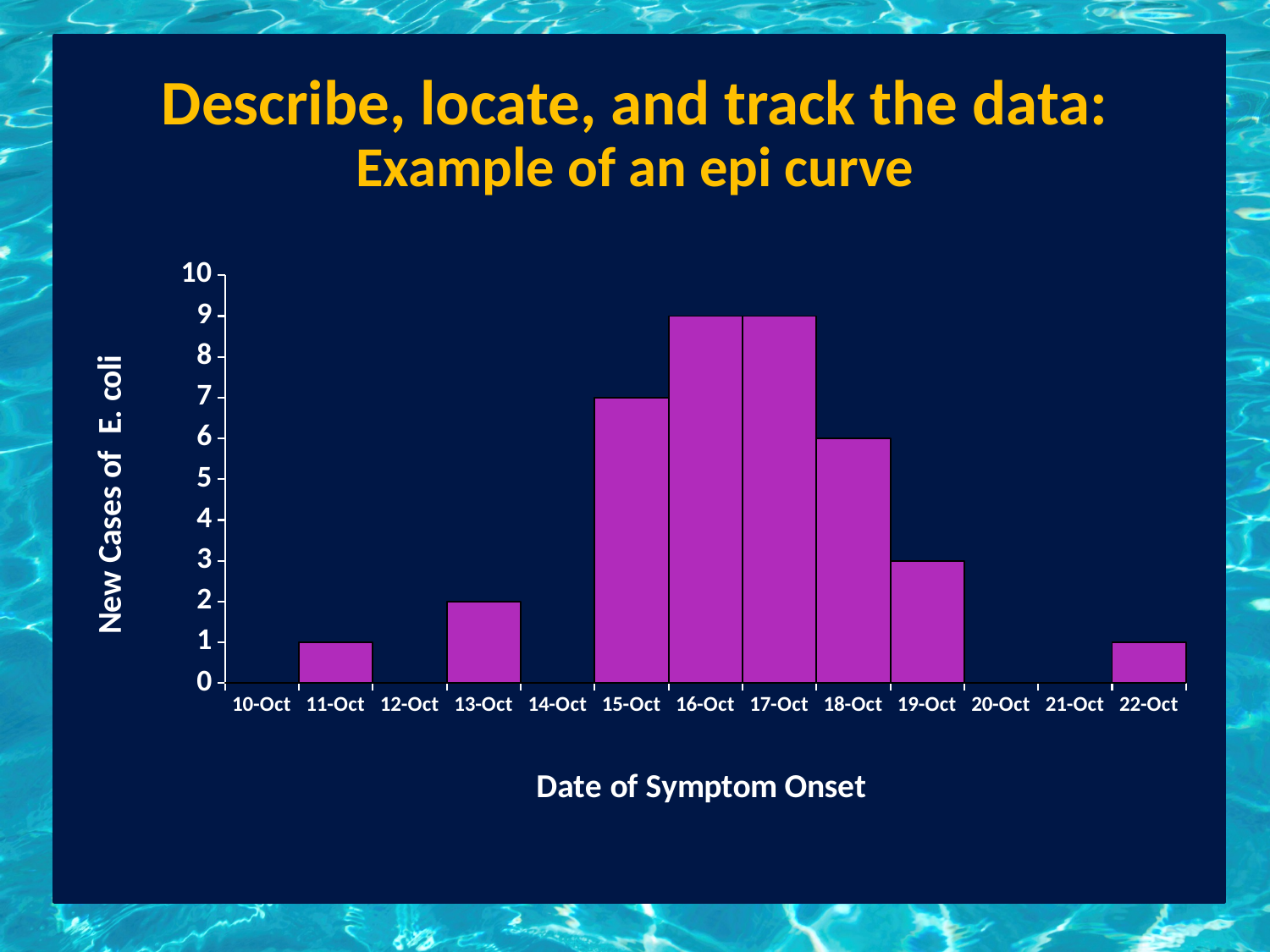
How many new E. coli cases had symptom onset on 13-Oct? 2 How many dates are shown on the x axis? 13 Which date has more new cases, 15-Oct or 18-Oct? 15-Oct How many new E. coli cases had symptom onset on 16-Oct? 9 What is the highest number of new cases recorded on a single date? 9 What is the difference in new cases between 17-Oct and 19-Oct? 6 What type of chart is shown on the slide? Bar chart How many new E. coli cases had symptom onset on 19-Oct? 3 Which two dates share the highest number of new cases? 16-Oct and 17-Oct Do the number of new cases rise or fall from 17-Oct to 19-Oct? Fall Is the number of new cases on 18-Oct greater or less than 5? greater How many new E. coli cases had symptom onset on 15-Oct? 7